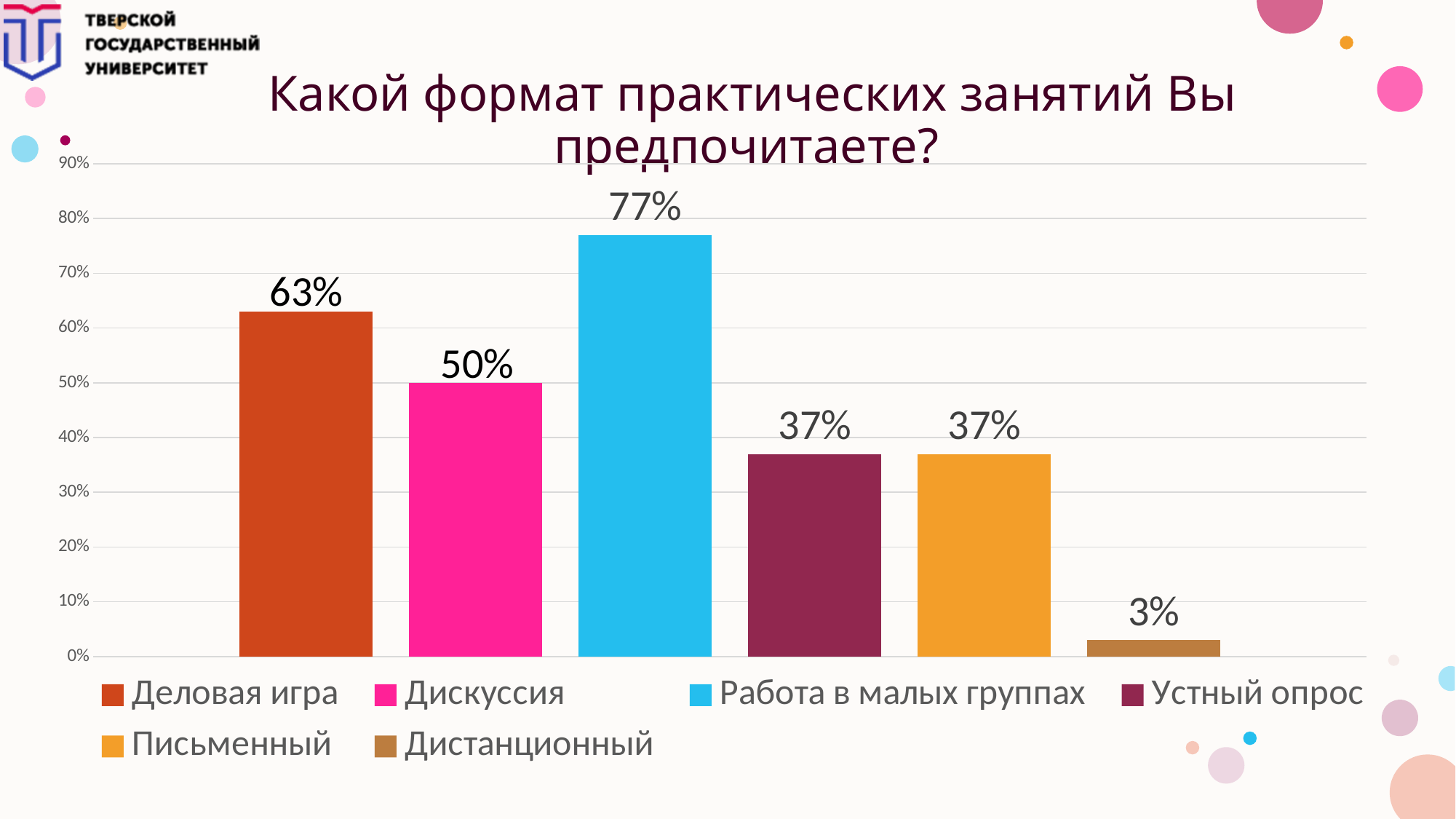
What kind of chart is shown on the slide? bar chart What is the value for Работа в малых группах? 77% Which is larger, the value for Деловая игра or the value for Дискуссия? Деловая игра What is the difference between the values for Дискуссия and Устный опрос? 13% Which format has the lowest value? Дистанционный Which format has the highest value? Работа в малых группах What is the value for Дискуссия? 50% What is the difference between the values for Работа в малых группах and Деловая игра? 14% How many entries does the legend list? 6 What is the value for Дистанционный? 3% What is the value for Деловая игра? 63% How many formats are shown in the chart? 6